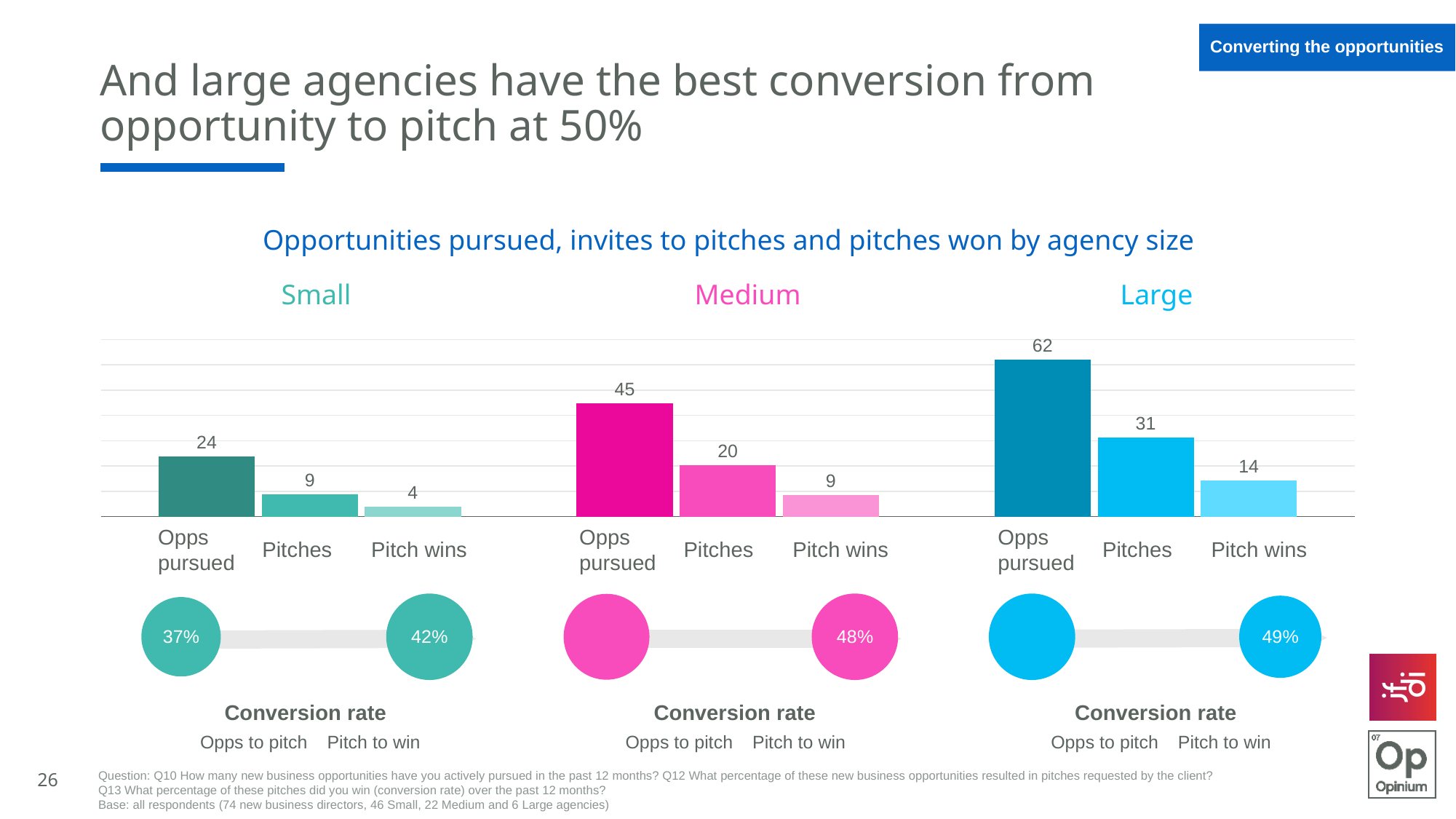
What is the value for Opps pursued for Large agencies? 62 What is the value for Pitch wins for Small agencies? 4 What kind of chart is used to show opportunities pursued, pitches and pitch wins? Bar chart What is the difference between Pitches for Medium agencies and Pitches for Small agencies? 11 What is the Pitch to win conversion rate shown for Medium agencies? 48% Which agency size has the lowest value for Pitch wins? Small What is the Opps to pitch conversion rate shown for Small agencies? 37% Which agency size has the highest value for Opps pursued? Large How many bars are plotted in the chart in total? 9 How many pitches are shown for Medium agencies? 20 Which is larger: Pitch wins for Large agencies or Pitches for Small agencies? Pitch wins for Large agencies What is the difference between Opps pursued and Pitches for Large agencies? 31